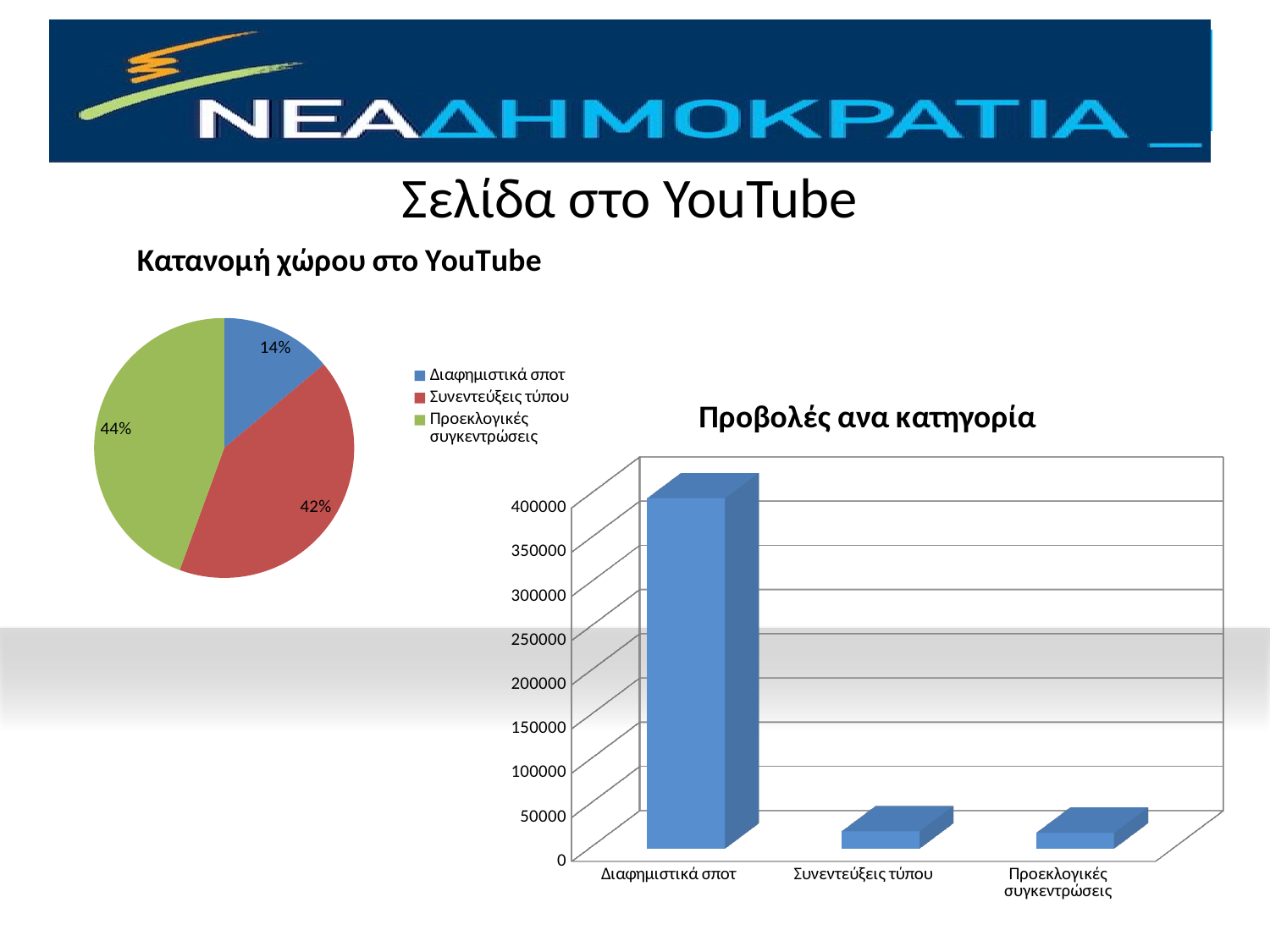
In the chart 'Προβολές ανα κατηγορία', is the value for 'Συνεντεύξεις τύπου' greater or less than 50000? less In the chart 'Προβολές ανα κατηγορία', is the value for 'Διαφημιστικά σποτ' greater or less than 350000? greater What kind of chart is 'Προβολές ανα κατηγορία'? Bar chart In the chart 'Προβολές ανα κατηγορία', which category has the highest value? Διαφημιστικά σποτ In the pie chart 'Κατανομή χώρου στο YouTube', what colour is the slice for 'Συνεντεύξεις τύπου'? Red In the pie chart 'Κατανομή χώρου στο YouTube', what share does 'Προεκλογικές συγκεντρώσεις' have? 44% In the pie chart 'Κατανομή χώρου στο YouTube', what share does 'Συνεντεύξεις τύπου' have? 42% In the pie chart 'Κατανομή χώρου στο YouTube', which category has the smallest share? Διαφημιστικά σποτ In the pie chart 'Κατανομή χώρου στο YouTube', what share does 'Διαφημιστικά σποτ' have? 14% In the pie chart 'Κατανομή χώρου στο YouTube', what is the difference in percentage points between 'Προεκλογικές συγκεντρώσεις' and 'Διαφημιστικά σποτ'? 30 percentage points How many entries does the legend of the pie chart 'Κατανομή χώρου στο YouTube' list? 3 In the pie chart 'Κατανομή χώρου στο YouTube', which category has the largest share? Προεκλογικές συγκεντρώσεις